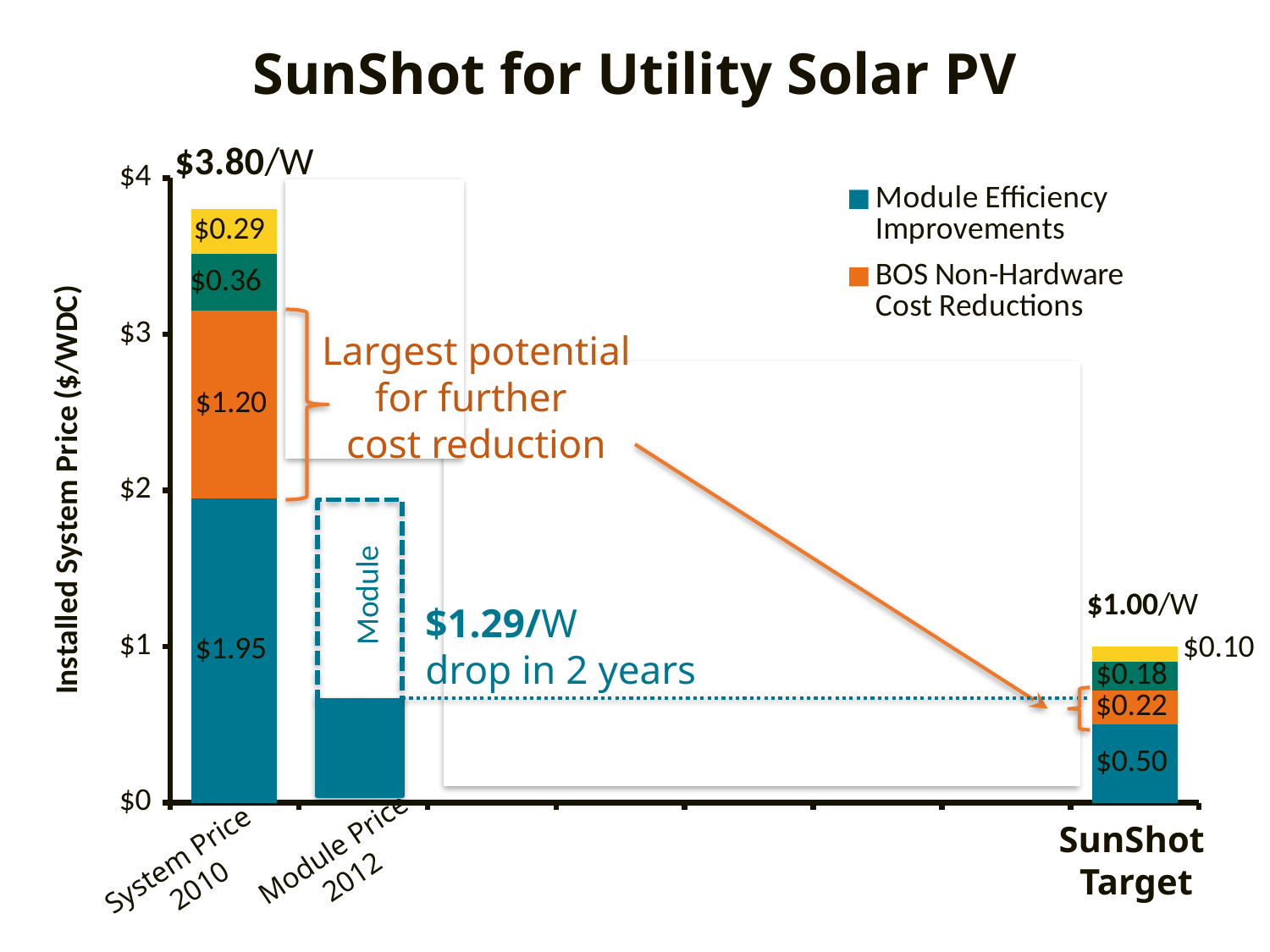
What is the value of the teal (module) segment in the System Price 2010 bar? $1.95 What is the value of the yellow segment in the SunShot Target bar? $0.10 What is the value of the orange segment in the SunShot Target bar? $0.22 What is the total installed system price shown for System Price 2010? $3.80/W Is the Module Price 2012 bar greater or less than $1? less What is the total installed system price shown for the SunShot Target? $1.00/W What is the value of the teal (module) segment in the SunShot Target bar? $0.50 How many entries does the legend list? 2 What is the difference between the orange segment in System Price 2010 and the orange segment in the SunShot Target? $0.98 What type of chart is shown on the slide? stacked bar chart What is the value of the orange segment in the System Price 2010 bar? $1.20 Which bar has the highest total installed system price? System Price 2010